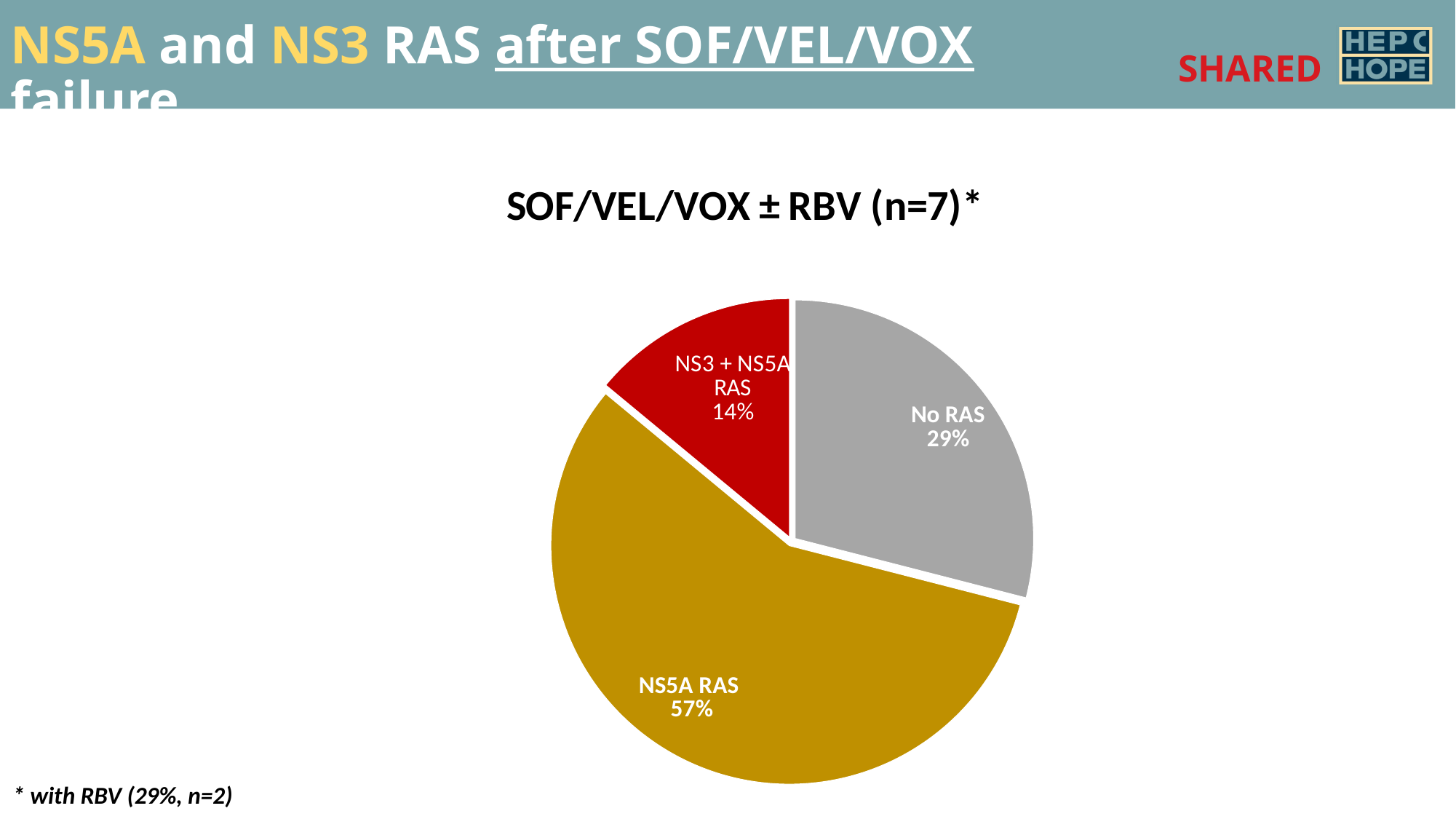
What share of the pie is labelled NS5A RAS? 57% What is the difference in percentage points between the No RAS slice and the NS3 + NS5A RAS slice? 15 What is the difference in percentage points between the NS5A RAS slice and the No RAS slice? 28 Which is larger, the No RAS slice or the NS3 + NS5A RAS slice? No RAS Which slice of the pie is the smallest? NS3 + NS5A RAS How many slices does the pie chart have? 3 What share of the pie is labelled No RAS? 29% What share of the pie is labelled NS3 + NS5A RAS? 14% Which slice of the pie is the largest? NS5A RAS What colour is the NS5A RAS slice? gold What is the title of the chart? SOF/VEL/VOX ± RBV (n=7)* What kind of chart is shown on the slide? pie chart